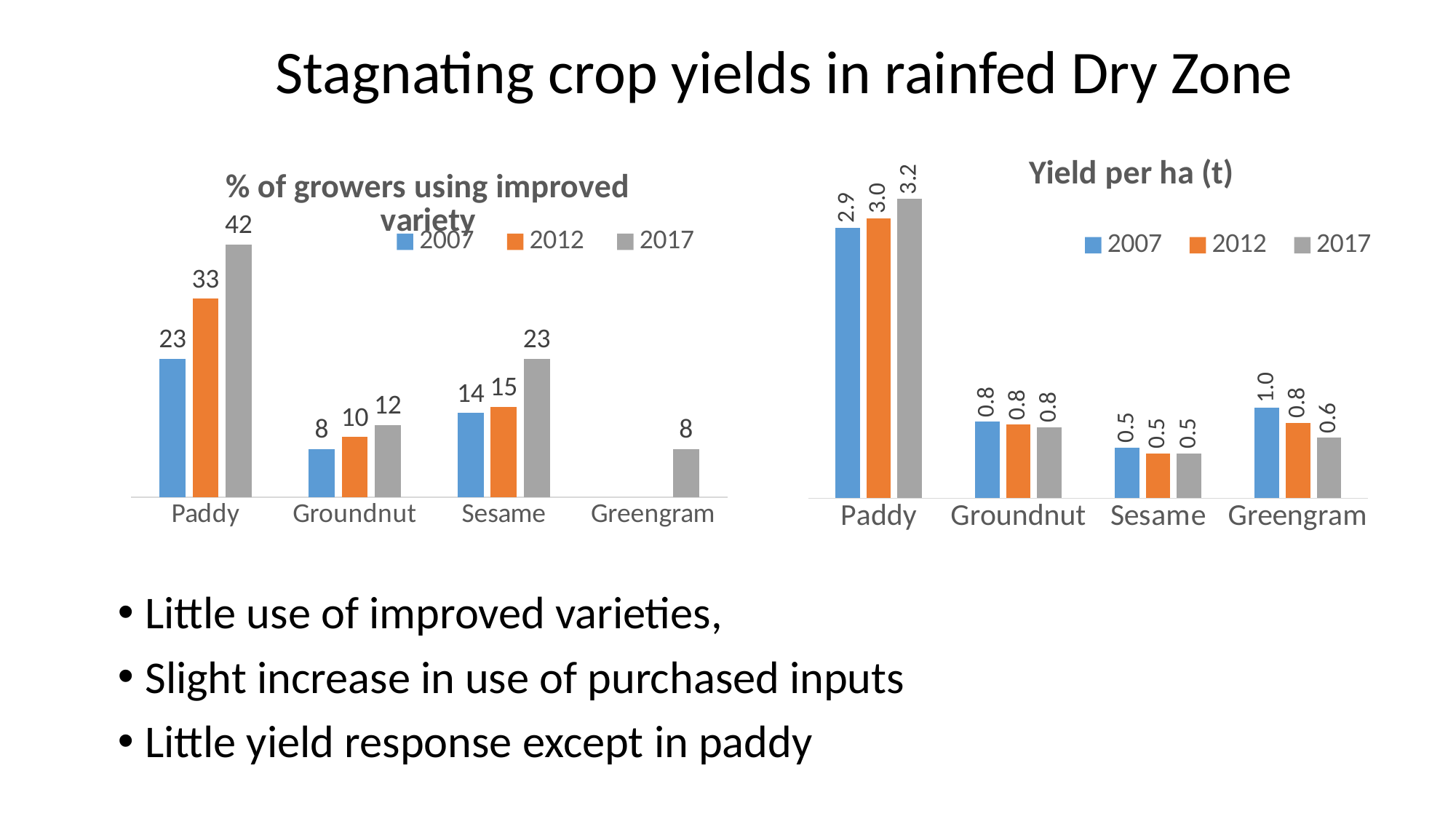
In the 'Yield per ha (t)' chart, what is the value for Greengram in 2017? 0.6 What type of chart is the 'Yield per ha (t)' chart? Bar chart In the 'Yield per ha (t)' chart, what is the difference between the 2007 and 2017 values for Greengram? 0.4 In the 'Yield per ha (t)' chart, which crop has the lowest yield in 2007? Sesame In the '% of growers using improved variety' chart, what is the value for Sesame in 2012? 15 How many crop categories are shown in the 'Yield per ha (t)' chart? 4 In the '% of growers using improved variety' chart, which is larger: Groundnut in 2017 or Sesame in 2017? Sesame in 2017 How many series does the legend of the '% of growers using improved variety' chart list? 3 In the '% of growers using improved variety' chart, which crop has the highest value in 2017? Paddy In the 'Yield per ha (t)' chart, what is the value for Paddy in 2012? 3.0 In the '% of growers using improved variety' chart, what is the difference between the 2017 and 2007 values for Paddy? 19 In the '% of growers using improved variety' chart, what is the value for Paddy in 2017? 42